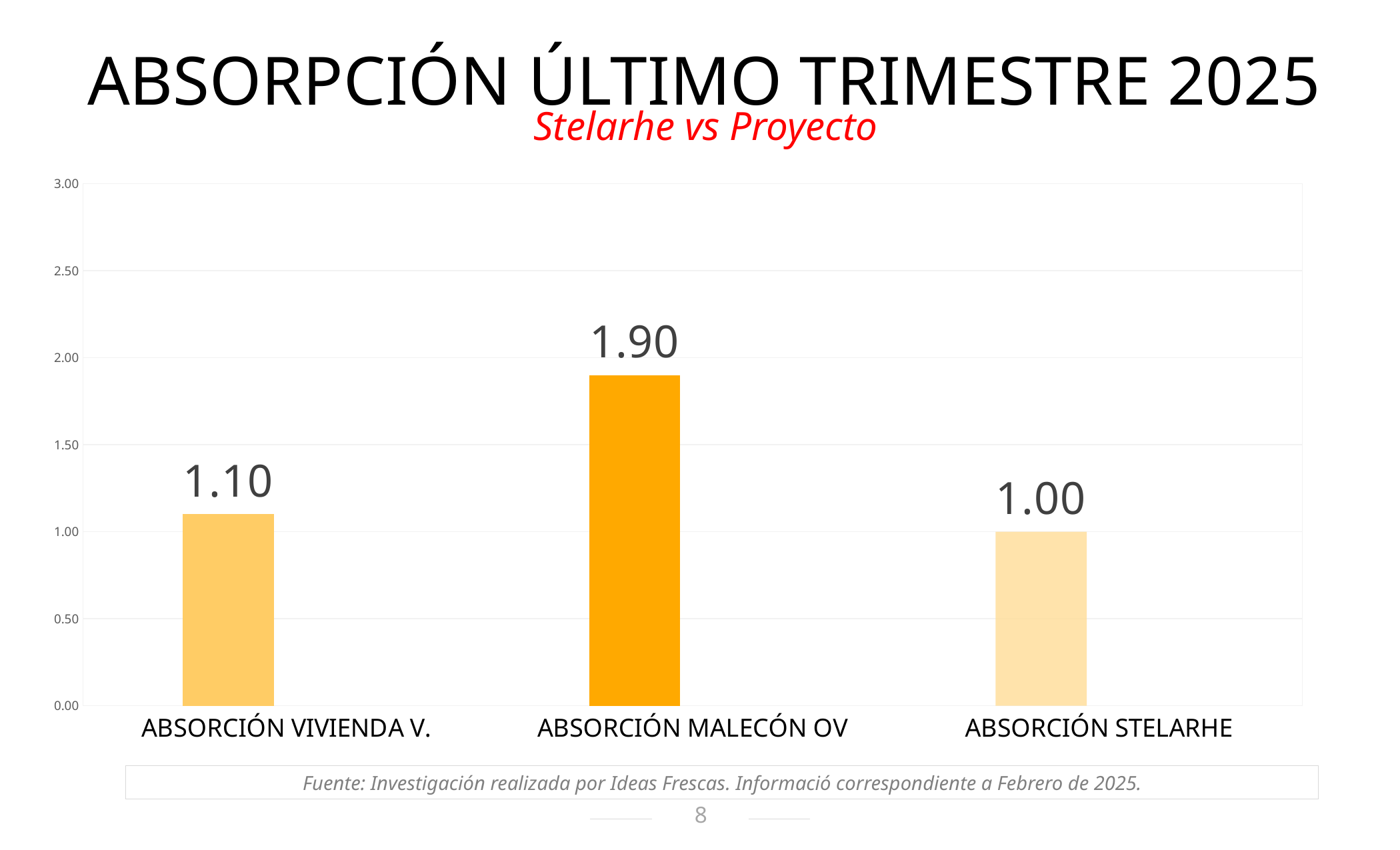
How many categories are shown in the chart? 3 What is the difference between the values for ABSORCIÓN VIVIENDA V. and ABSORCIÓN STELARHE? 0.10 Is the value for ABSORCIÓN MALECÓN OV greater or less than 1.50? greater Which is larger, the value for ABSORCIÓN VIVIENDA V. or the value for ABSORCIÓN MALECÓN OV? ABSORCIÓN MALECÓN OV What is the value for ABSORCIÓN MALECÓN OV? 1.90 What is the red subtitle shown below the main title? Stelarhe vs Proyecto Which category has the lowest value? ABSORCIÓN STELARHE Which category has the highest value? ABSORCIÓN MALECÓN OV What is the value for ABSORCIÓN VIVIENDA V.? 1.10 What is the value for ABSORCIÓN STELARHE? 1.00 What kind of chart is shown on the slide? bar chart What is the difference between the values for ABSORCIÓN MALECÓN OV and ABSORCIÓN STELARHE? 0.90